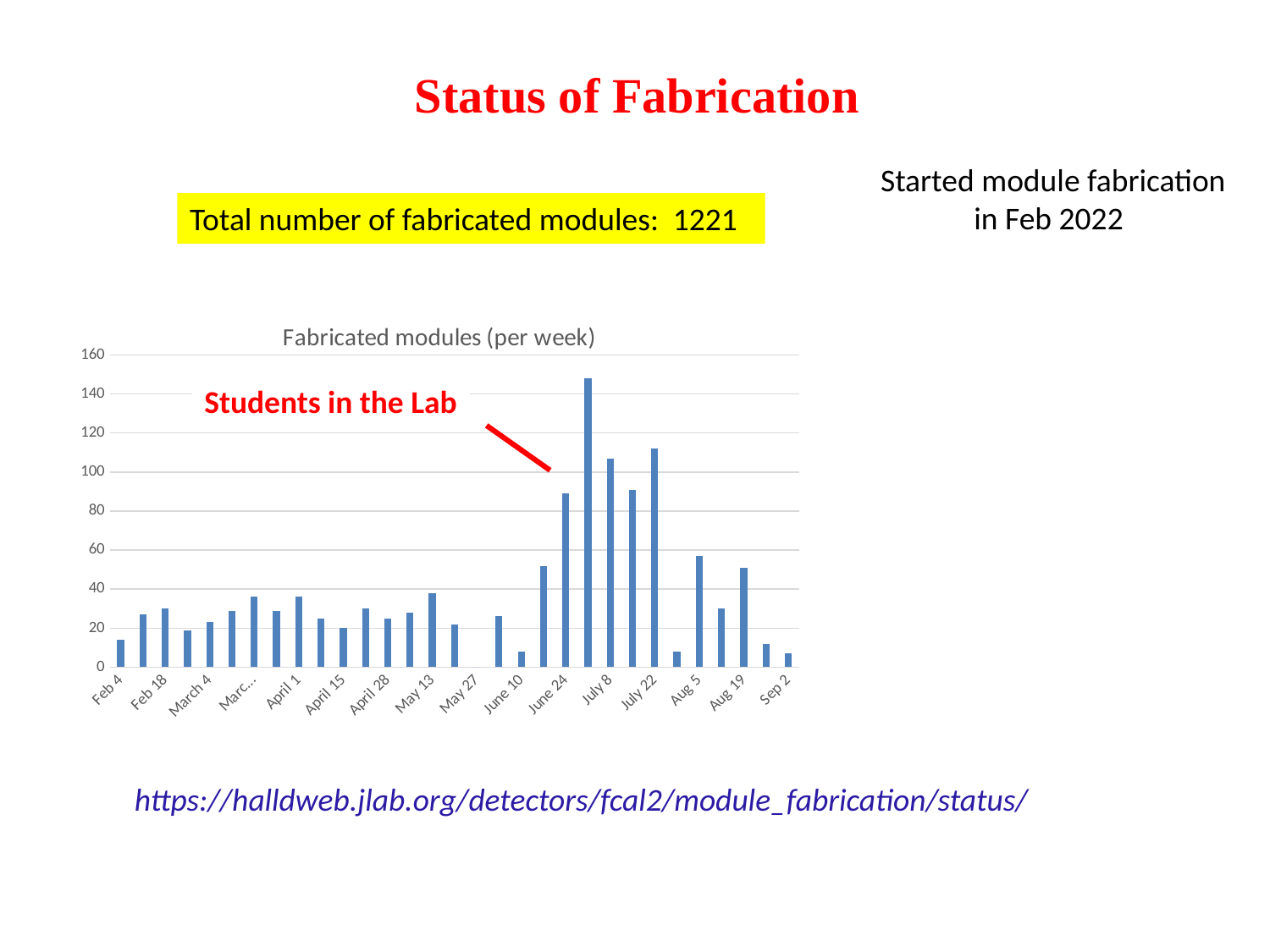
What is the highest value shown on the chart's vertical axis? 160 Do the values generally rise or fall from Aug 5 to Sep 2? fall Which is larger, the value for June 24 or the value for Feb 18? June 24 How many date labels are shown along the x axis of the chart? 16 Is the value for July 22 greater or less than 100? greater What kind of chart is shown on the slide? bar chart Is the value for June 24 greater or less than 80? greater What is the title of the chart? Fabricated modules (per week) Is the value for Aug 5 greater or less than 40? greater Which is larger, the value for July 22 or the value for Aug 5? July 22